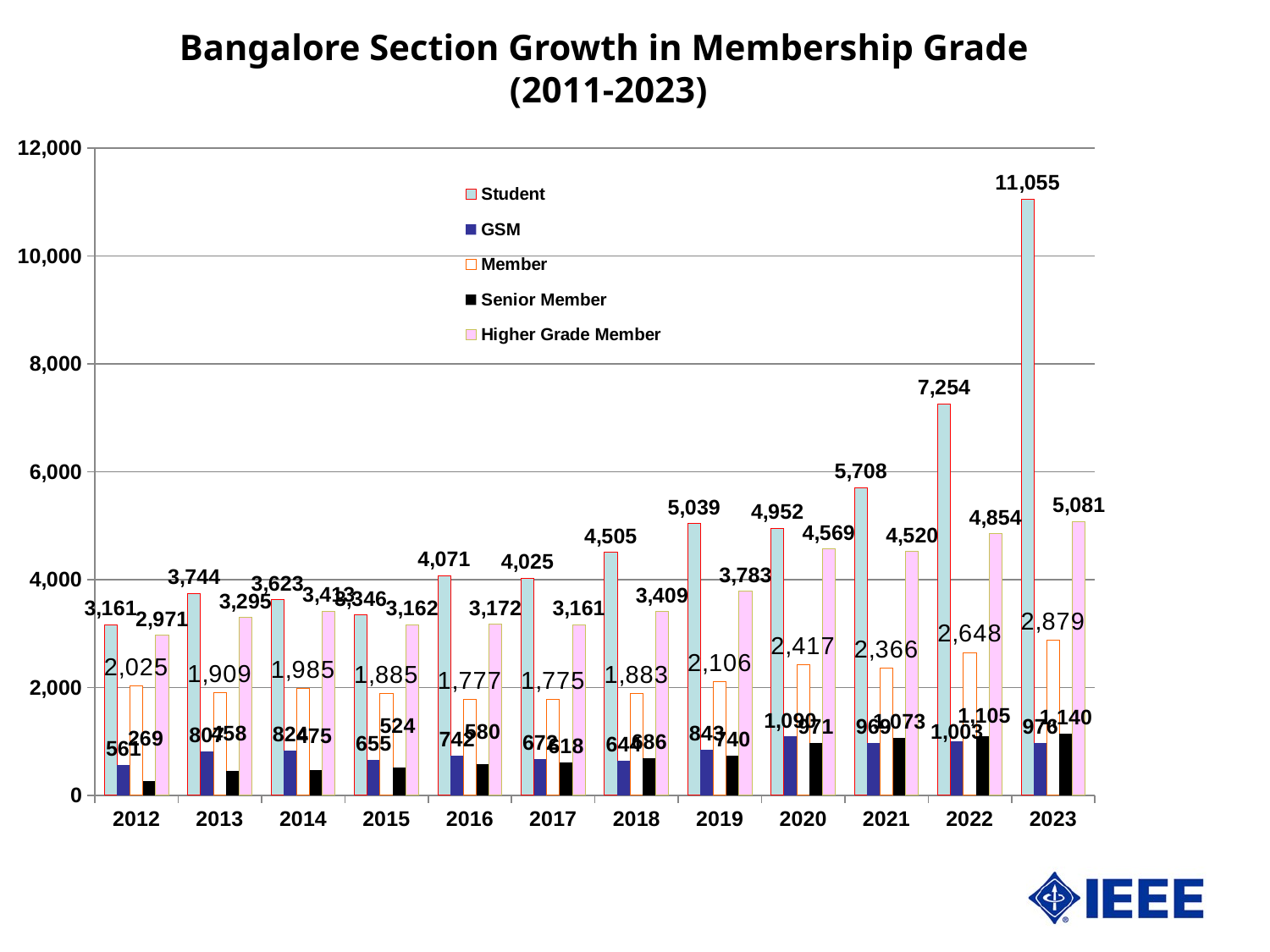
What is the Student value for 2023? 11,055 How many years are shown on the x axis? 12 What is the Higher Grade Member value for 2020? 4,569 In which year is the Student value lowest? 2012 Which year has the larger Student value, 2019 or 2020? 2019 Do the Senior Member values rise or fall from 2012 to 2023? rise What is the Senior Member value for 2023? 1,140 What is the difference between the Student values for 2023 and 2022? 3,801 How many series does the legend list? 5 In which year is the Student value highest? 2023 What kind of chart is shown on the slide? bar chart What is the Member value for 2022? 2,648